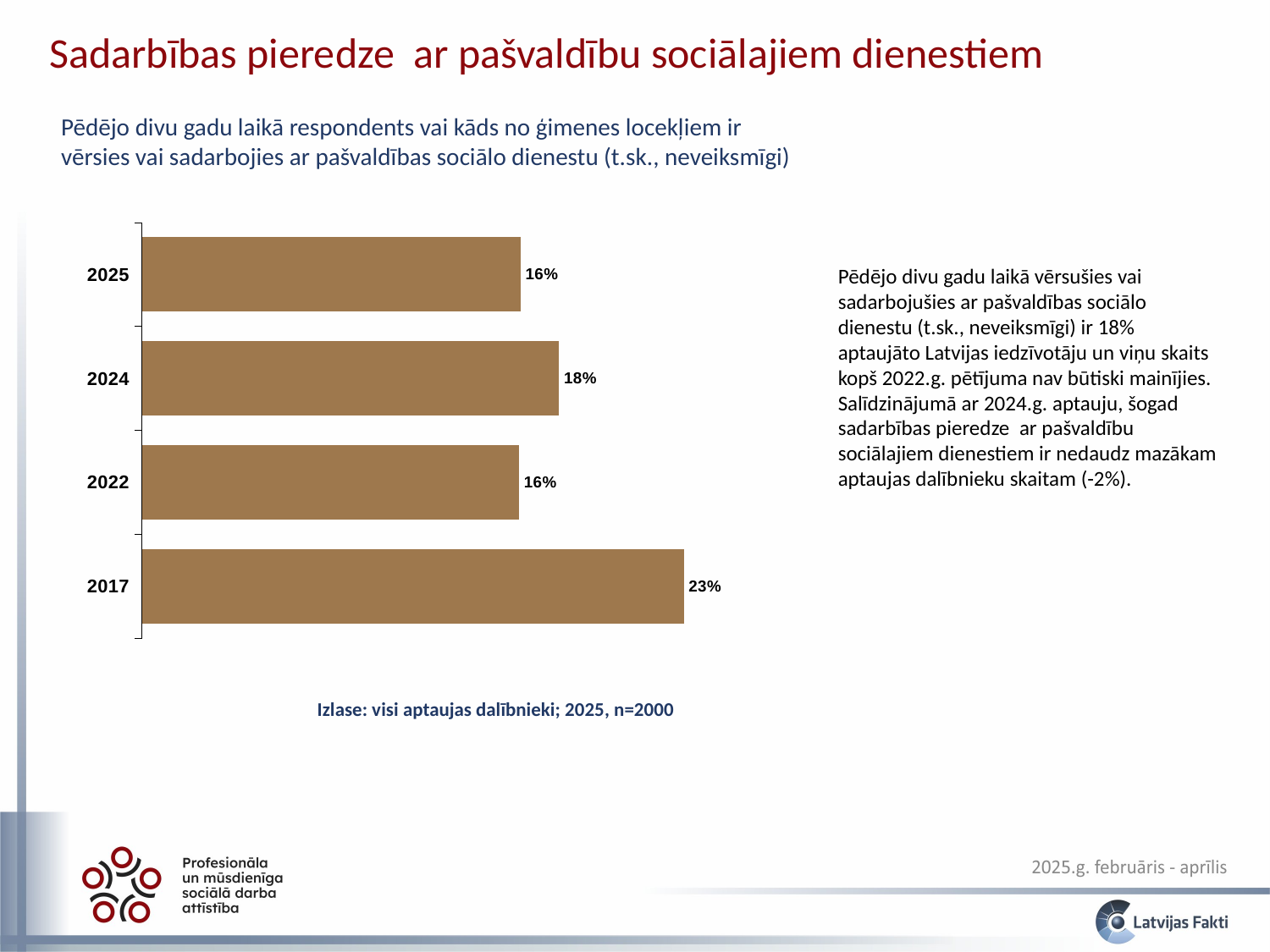
What is the value for 2025? 16% What is the value for 2024? 18% What is the difference between the values for 2017 and 2025? 7% What colour are the bars in the chart? Brown What is the difference between the values for 2024 and 2022? 2% Which is larger, the value for 2024 or the value for 2025? 2024 Which year has the highest value? 2017 Do the values for 2022 and 2025 differ? No, both are 16% What sample note is printed below the chart? Izlase: visi aptaujas dalībnieki; 2025, n=2000 How many years are shown in the chart? 4 What is the value for 2017? 23% What kind of chart is shown on the slide? Bar chart